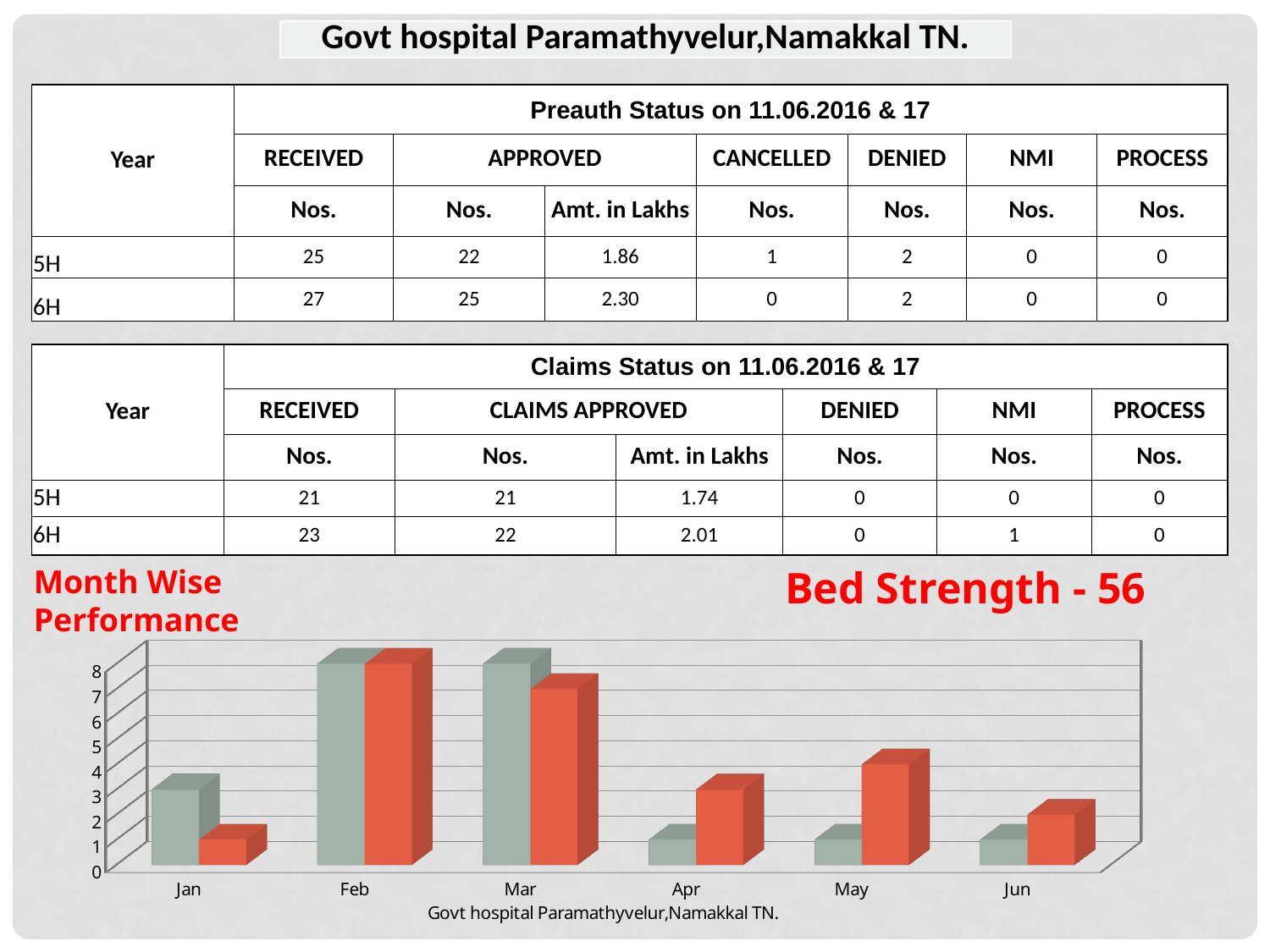
In the Month Wise Performance chart, is the red bar for Jan greater or less than 2? less How many bars are plotted for each month in the Month Wise Performance chart? 2 In the Month Wise Performance chart, which bar is taller for May, the grey bar or the red bar? the red bar In the Month Wise Performance chart, which bar is taller for Jan, the grey bar or the red bar? the grey bar What text appears below the x axis of the Month Wise Performance chart? Govt hospital Paramathyvelur,Namakkal TN. What kind of chart is shown at the bottom of the slide? bar chart How many months are shown on the x axis of the Month Wise Performance chart? 6 In the Month Wise Performance chart, is the grey bar for Feb greater or less than 6? greater What is the heading written in red above the chart on the left? Month Wise Performance In the Month Wise Performance chart, is the red bar for May greater or less than 2? greater In the Month Wise Performance chart, which month has the lowest red bar? Jan